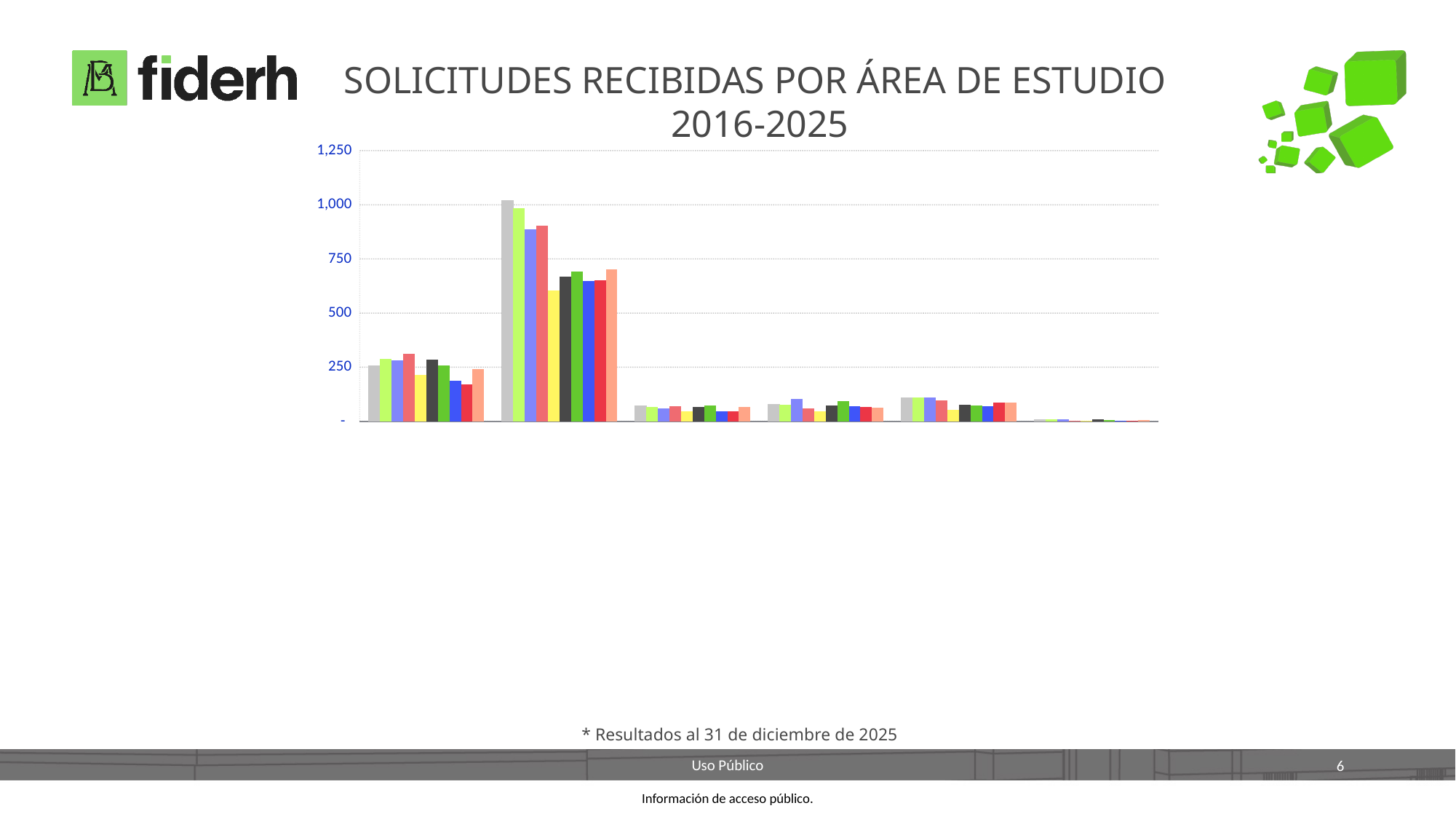
How many bars are there in each group? 10 What is the title of the chart? SOLICITUDES RECIBIDAS POR ÁREA DE ESTUDIO 2016-2025 Is the tallest bar in the first group from the left greater or less than 500? less Is the tallest bar in the third group from the left greater or less than 250? less Which group of bars, counting from the left, contains the tallest bar? the second group Which group of bars, counting from the left, has the smallest bars? the sixth group Which group has taller bars overall, the first group or the fifth group from the left? the first group What kind of chart is shown on the slide? bar chart Is the tallest bar in the second group from the left greater or less than 750? greater How many groups of bars are plotted along the x axis? 6 What is the highest value shown on the vertical axis? 1,250